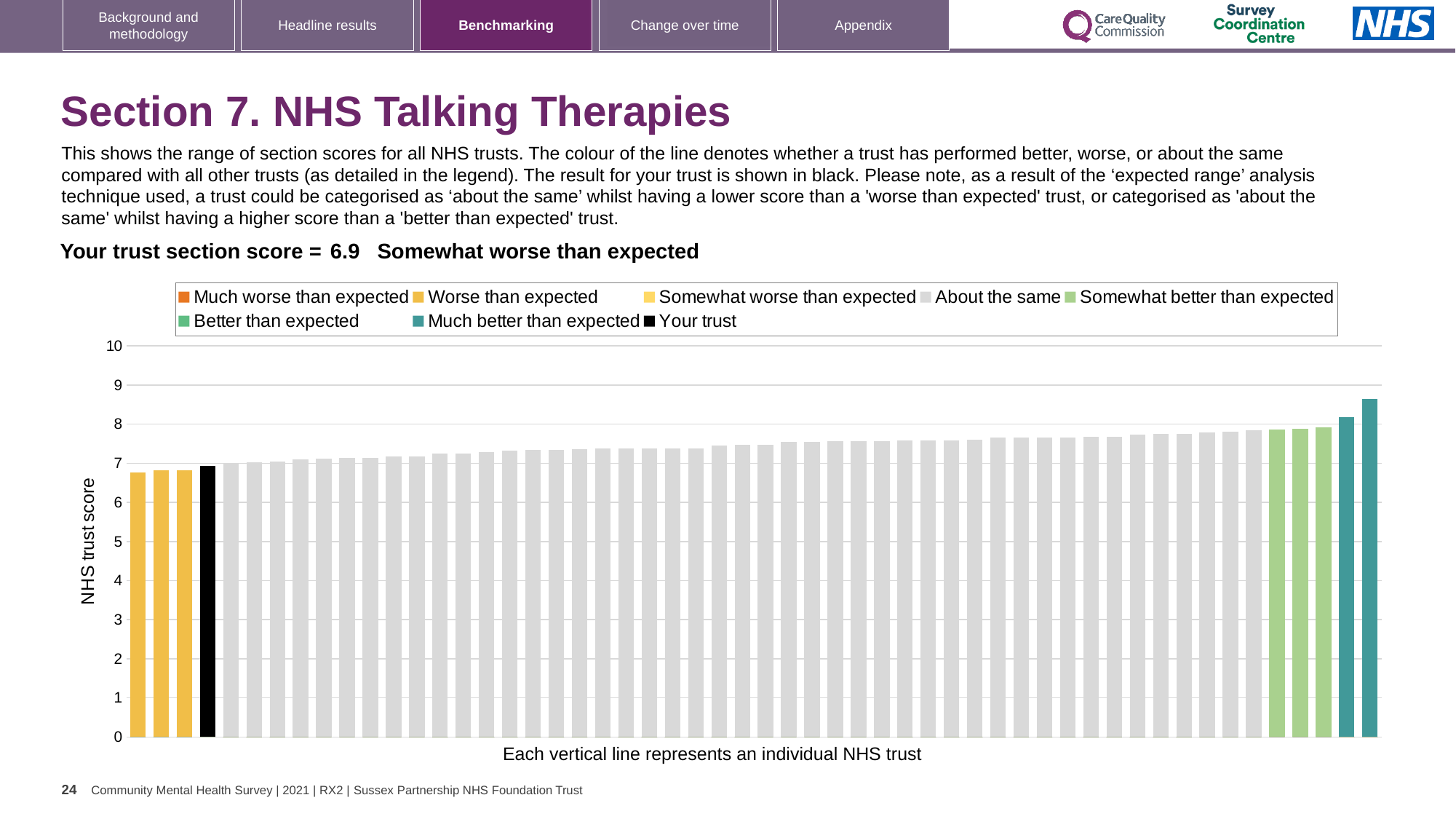
Is the value of the shortest bar greater or less than 7? less Do the bar values rise or fall from left to right along the x axis? rise What kind of chart is shown on the slide? bar chart Is the value of the tallest bar greater or less than 9? less Which legend category does the tallest bar belong to? Much better than expected How many bars are coloured light green (Somewhat better than expected)? 3 Is the value of the tallest bar greater or less than 8? greater What is the section score for your trust shown on the slide? 6.9 How many bars are coloured yellow (Worse than expected)? 3 How many bars are coloured teal (Much better than expected)? 2 What is the label on the y axis of the chart? NHS trust score How many entries does the chart legend list? 8